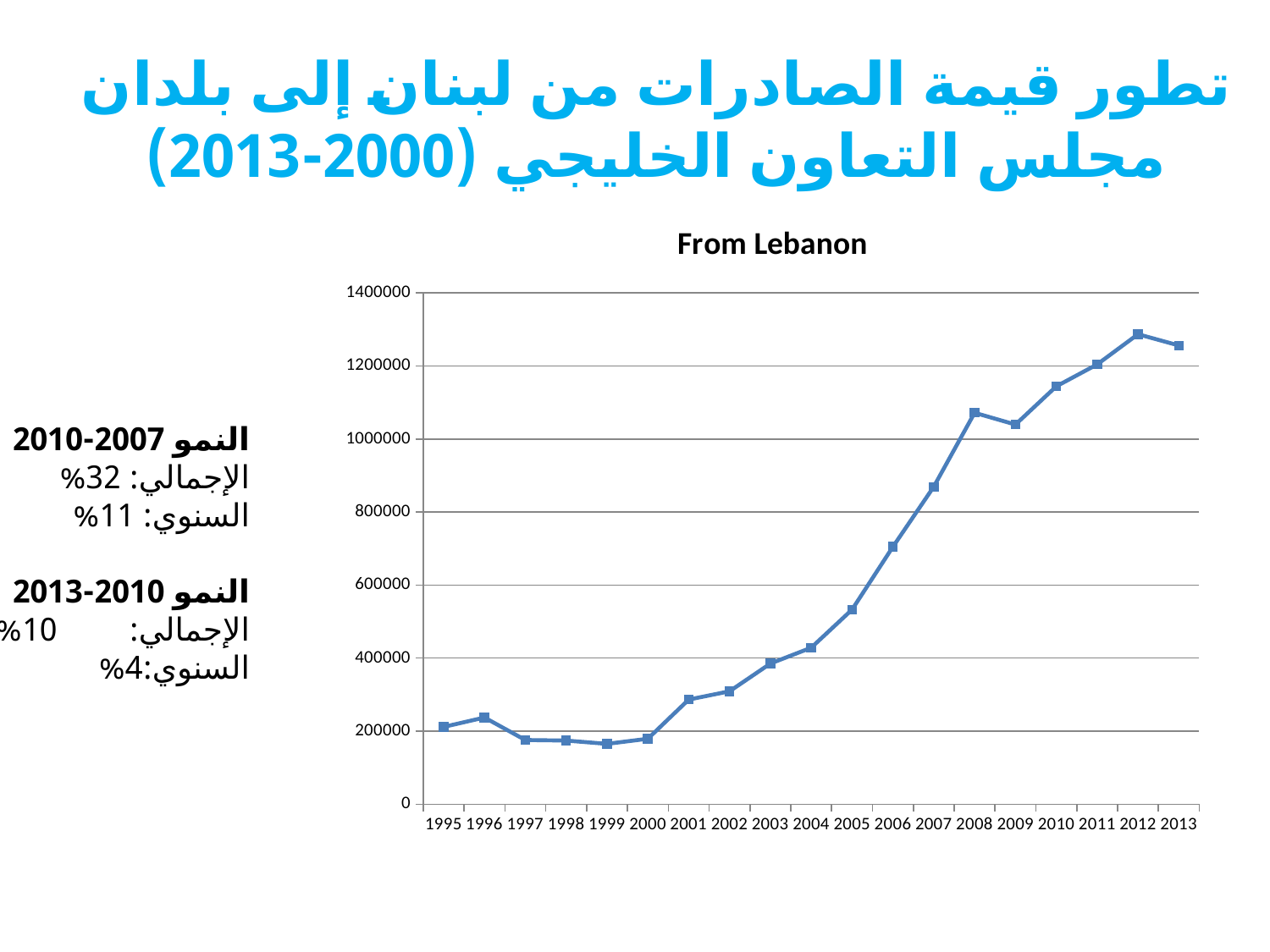
Is the value for 2005 greater or less than 600000? less What is the highest value shown on the y axis of the chart? 1400000 How many years are plotted along the x axis of the chart? 19 Is the value for 2000 greater or less than 200000? less Which year has the larger value, 2012 or 2013? 2012 What is the title of the chart? From Lebanon Which year has the larger value, 2008 or 2009? 2008 What kind of chart is shown on the slide? line chart Is the value for 2006 greater or less than 600000? greater Do the values rise or fall between 2000 and 2008? rise In which year does the line reach its highest value? 2012